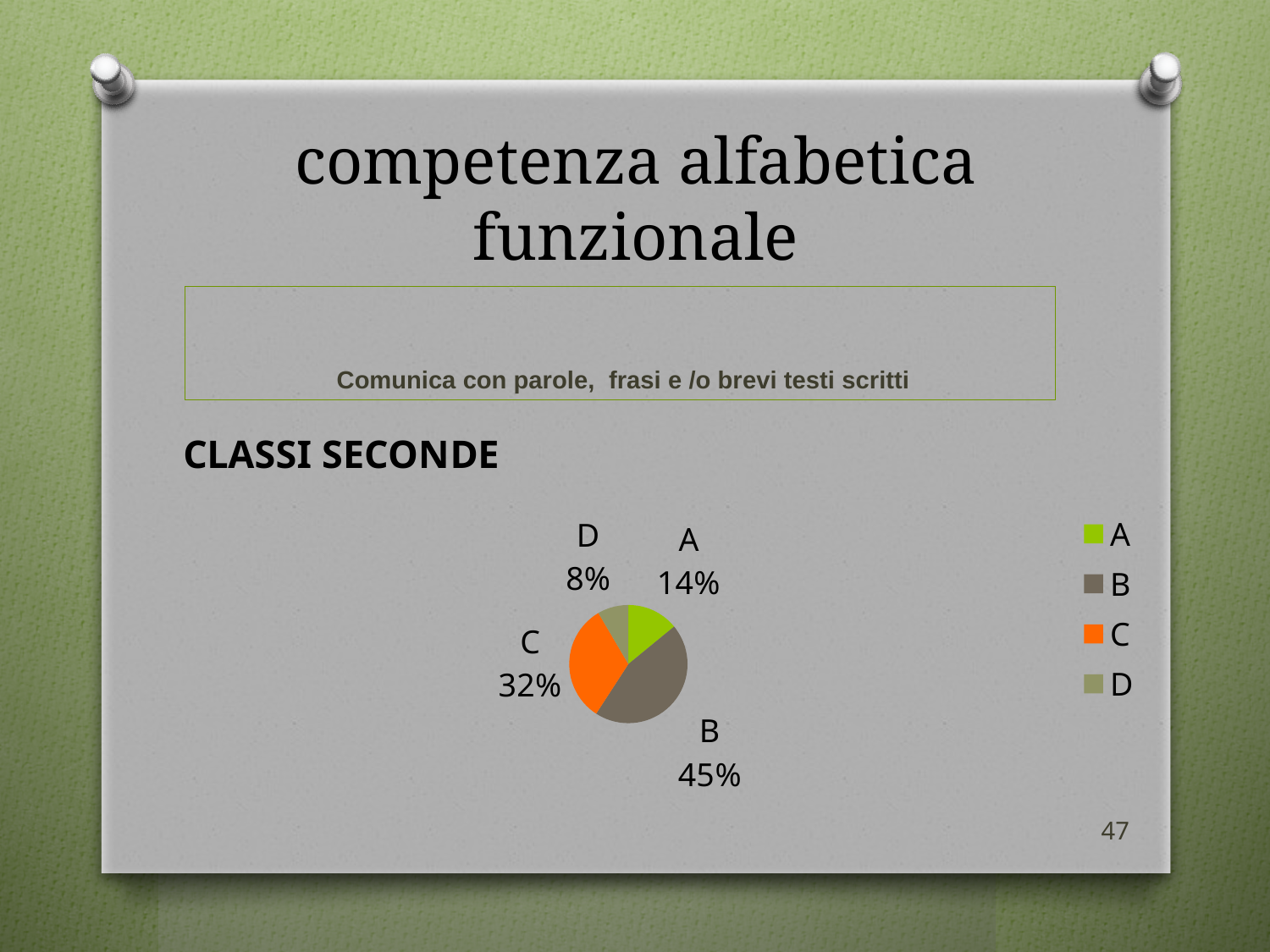
What is the difference in percentage points between slice B and slice C? 13 What kind of chart is shown on the slide? pie chart Which slice has the smallest share of the pie? D How many entries does the legend list? 4 How many slices does the pie chart have? 4 What percentage is shown for slice A? 14% Which slice has the largest share of the pie? B Which is larger, slice A or slice D? A What colour is slice C in the pie chart? orange What percentage is shown for slice B? 45% What percentage is shown for slice C? 32% What percentage is shown for slice D? 8%